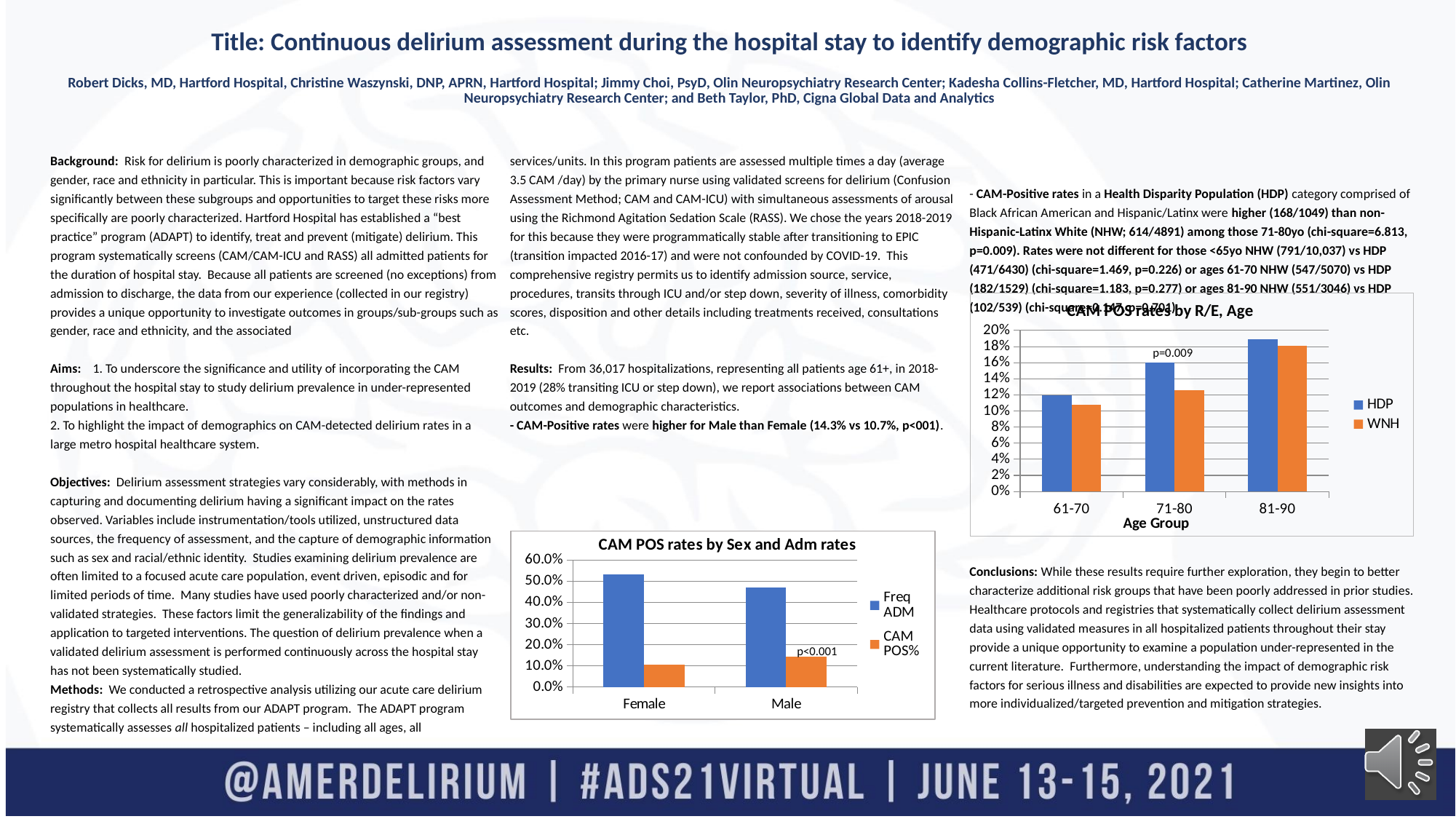
How many series does the legend of the 'CAM POS rates by Sex and Adm rates' chart list? 2 How many age groups are shown on the x axis of the 'CAM POS rates by R/E, Age' chart? 3 In the 'CAM POS rates by R/E, Age' chart, which age group has the highest HDP value? 81-90 In the 'CAM POS rates by Sex and Adm rates' chart, which category has the higher CAM POS% value, Female or Male? Male In the 'CAM POS rates by Sex and Adm rates' chart, is the CAM POS% value for Male greater or less than 20.0%? less What is the x-axis title of the 'CAM POS rates by R/E, Age' chart? Age Group In the 'CAM POS rates by R/E, Age' chart, is the HDP value for 71-80 greater or less than 14%? greater What p-value annotation is printed on the 'CAM POS rates by Sex and Adm rates' chart? p<0.001 In the 'CAM POS rates by Sex and Adm rates' chart, is the Freq ADM value for Female greater or less than 50.0%? greater How many categories are shown on the x axis of the 'CAM POS rates by Sex and Adm rates' chart? 2 What kind of chart is the 'CAM POS rates by Sex and Adm rates' chart? bar chart In the 'CAM POS rates by R/E, Age' chart, do the WNH values rise or fall from 61-70 to 81-90? rise